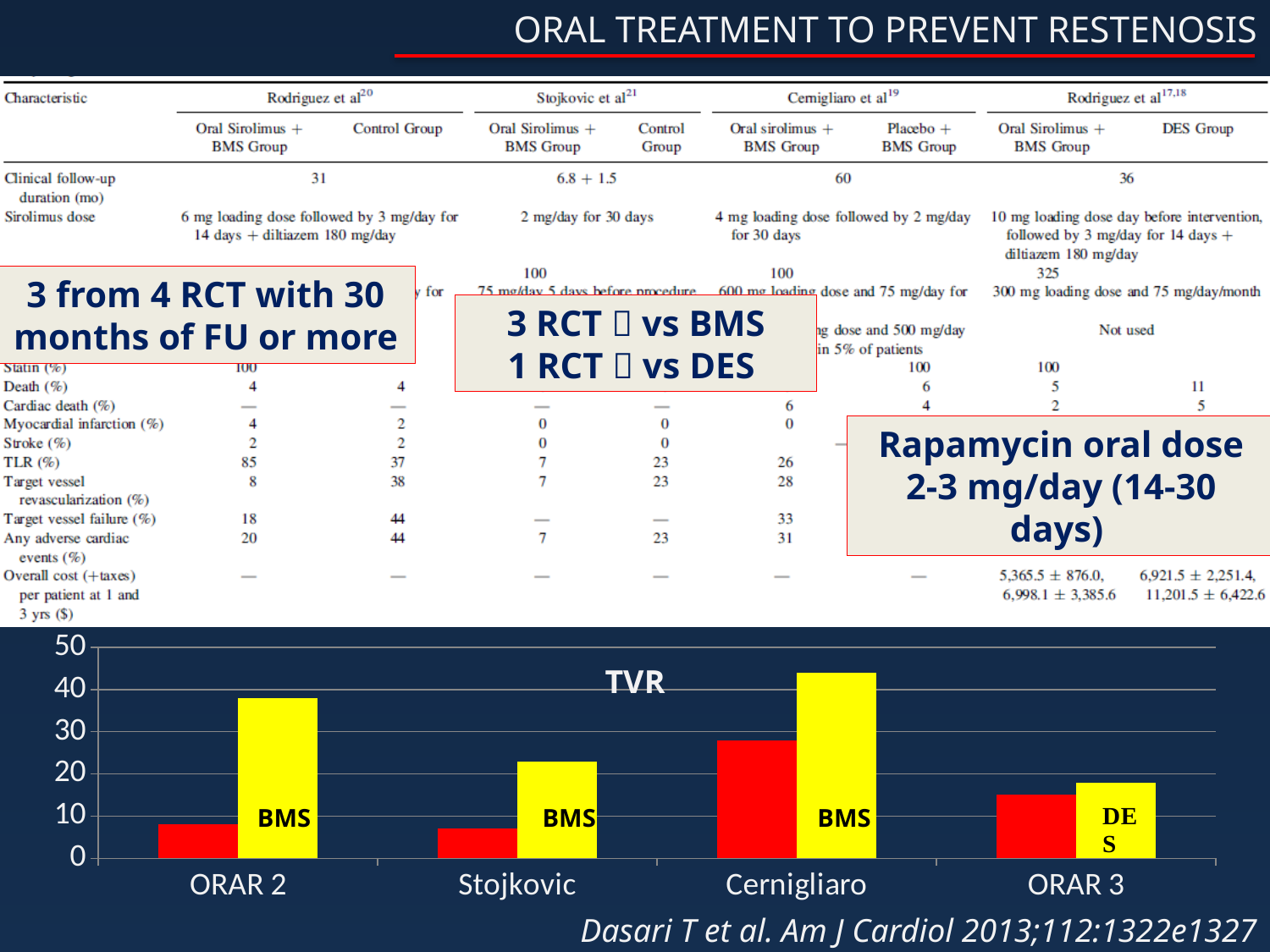
In the TVR chart, is the value of the red bar for Stojkovic greater or less than 10? less In the TVR chart, which category has the tallest bar overall? Cernigliaro In the TVR chart, which category has the shortest yellow bar? ORAR 3 How many categories are shown on the x axis of the TVR bar chart? 4 In the TVR chart, is the value of the yellow BMS bar for Stojkovic greater or less than 20? greater What is the title of the bar chart at the bottom of the slide? TVR In the TVR chart, is the value of the yellow BMS bar for ORAR 2 greater or less than 30? greater What kind of chart is shown at the bottom of the slide? bar chart In the TVR chart, for ORAR 2, which bar is taller, the red bar or the yellow BMS bar? the yellow BMS bar In the TVR chart, which category's yellow bar is labelled DES instead of BMS? ORAR 3